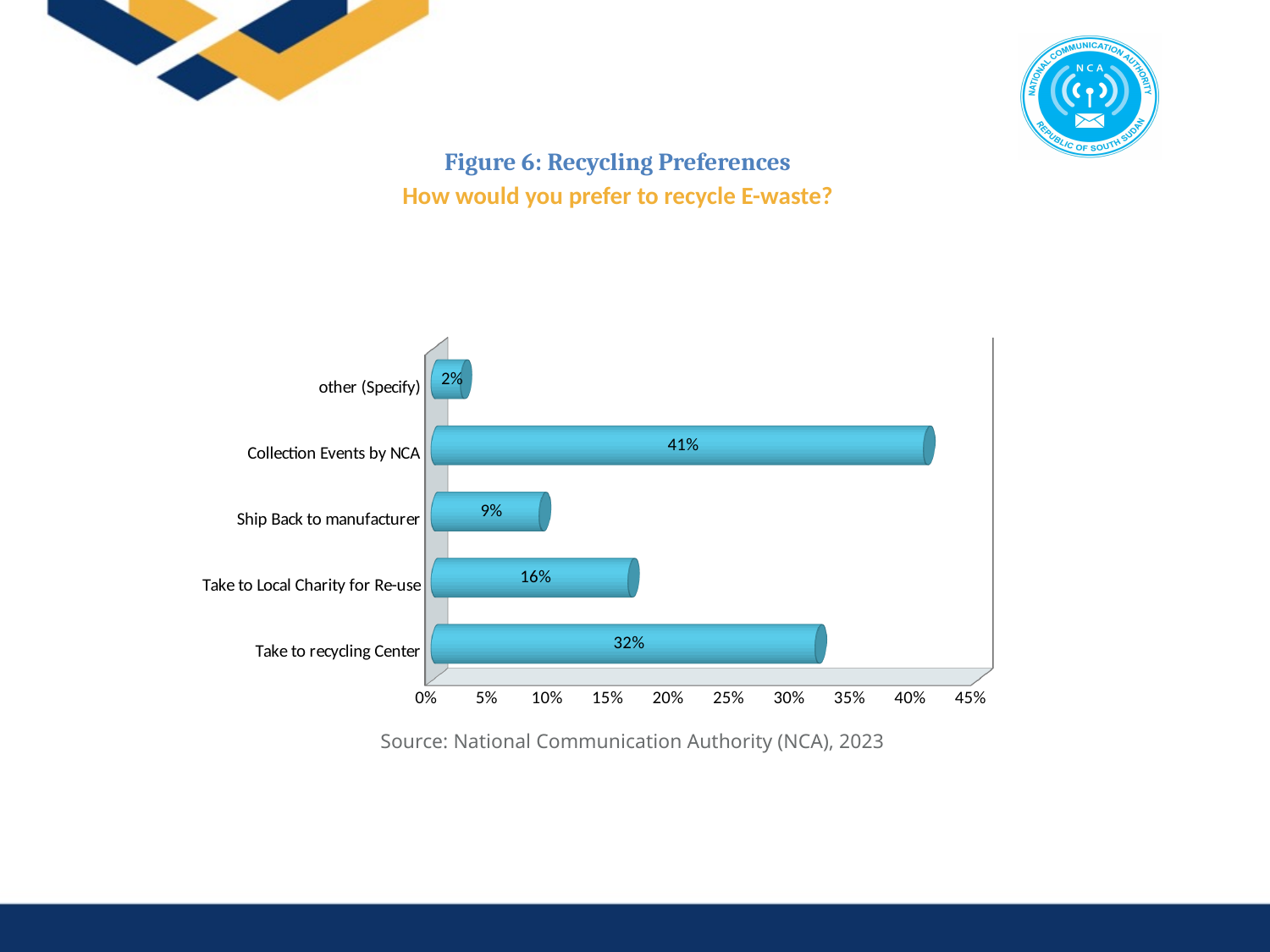
What percentage of respondents prefer Collection Events by NCA? 41% What is the difference between Collection Events by NCA and Take to recycling Center? 9% What is the value for Take to recycling Center? 32% What percentage prefer to Ship Back to manufacturer? 9% What is the difference between Take to Local Charity for Re-use and Ship Back to manufacturer? 7% Which category has the lowest value? other (Specify) What kind of chart is shown on the slide? bar chart Which recycling preference has the highest value? Collection Events by NCA Which is larger: Take to Local Charity for Re-use or Ship Back to manufacturer? Take to Local Charity for Re-use Is the value for Take to recycling Center greater or less than 30%? greater What is the title of the figure on the slide? Figure 6: Recycling Preferences How many categories are shown in the chart? 5